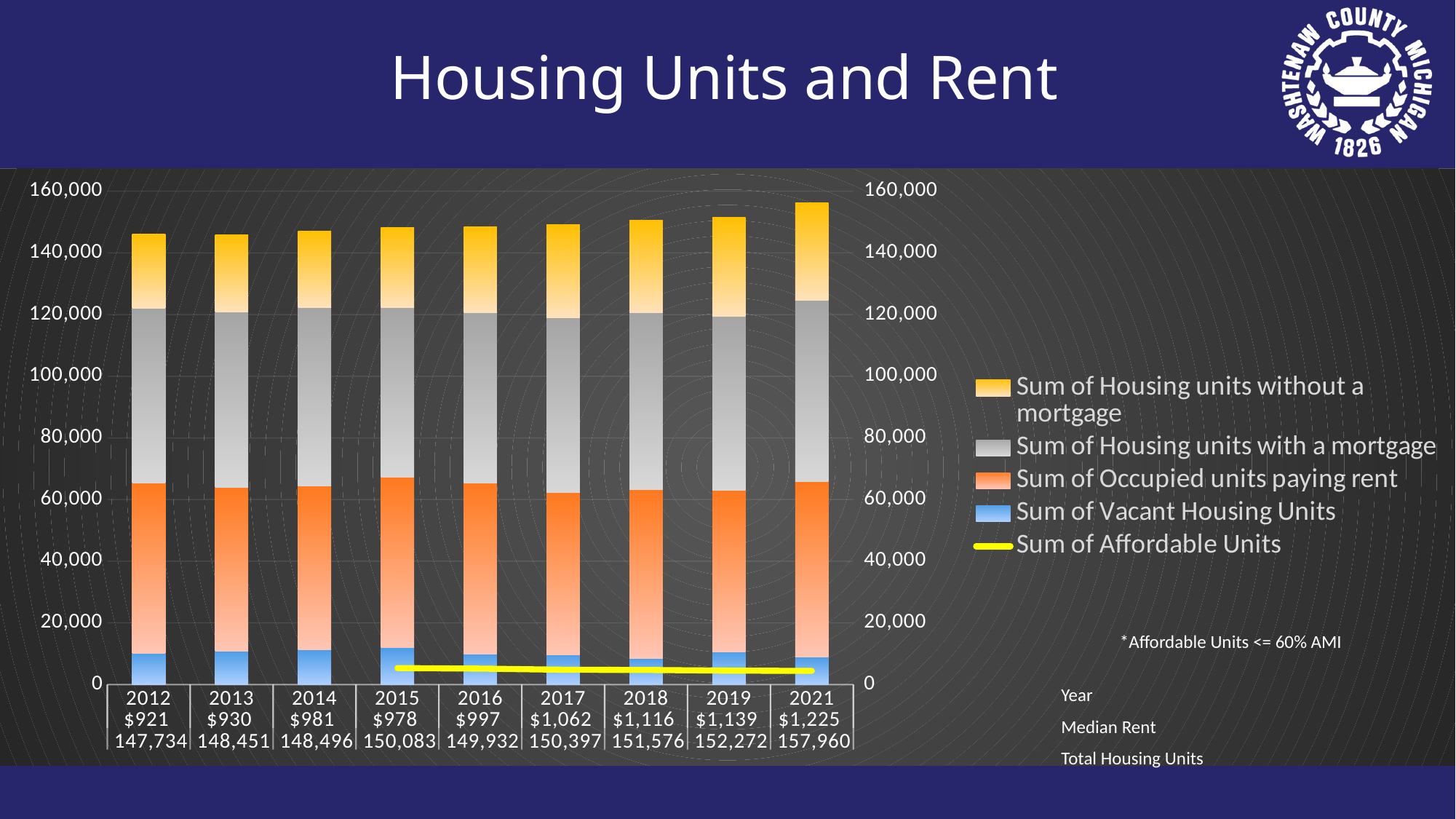
Which year had the higher median rent, 2014 or 2015? 2014 Which year has the lowest median rent? 2012 What kind of chart is shown on the slide? combination bar and line chart (stacked bars with a line) What is the difference between the median rent in 2021 and in 2012? $304 What was the median rent in 2012? $921 Which series is plotted as a yellow line rather than a bar segment? Sum of Affordable Units Which year has the highest total housing units? 2021 What was the total number of housing units in 2021? 157,960 Is the value for Sum of Vacant Housing Units in 2012 greater or less than 20,000? less How many years are shown along the x axis of the chart? 9 How many series does the chart legend list? 5 Does the median rent generally rise or fall from 2012 to 2021? rise